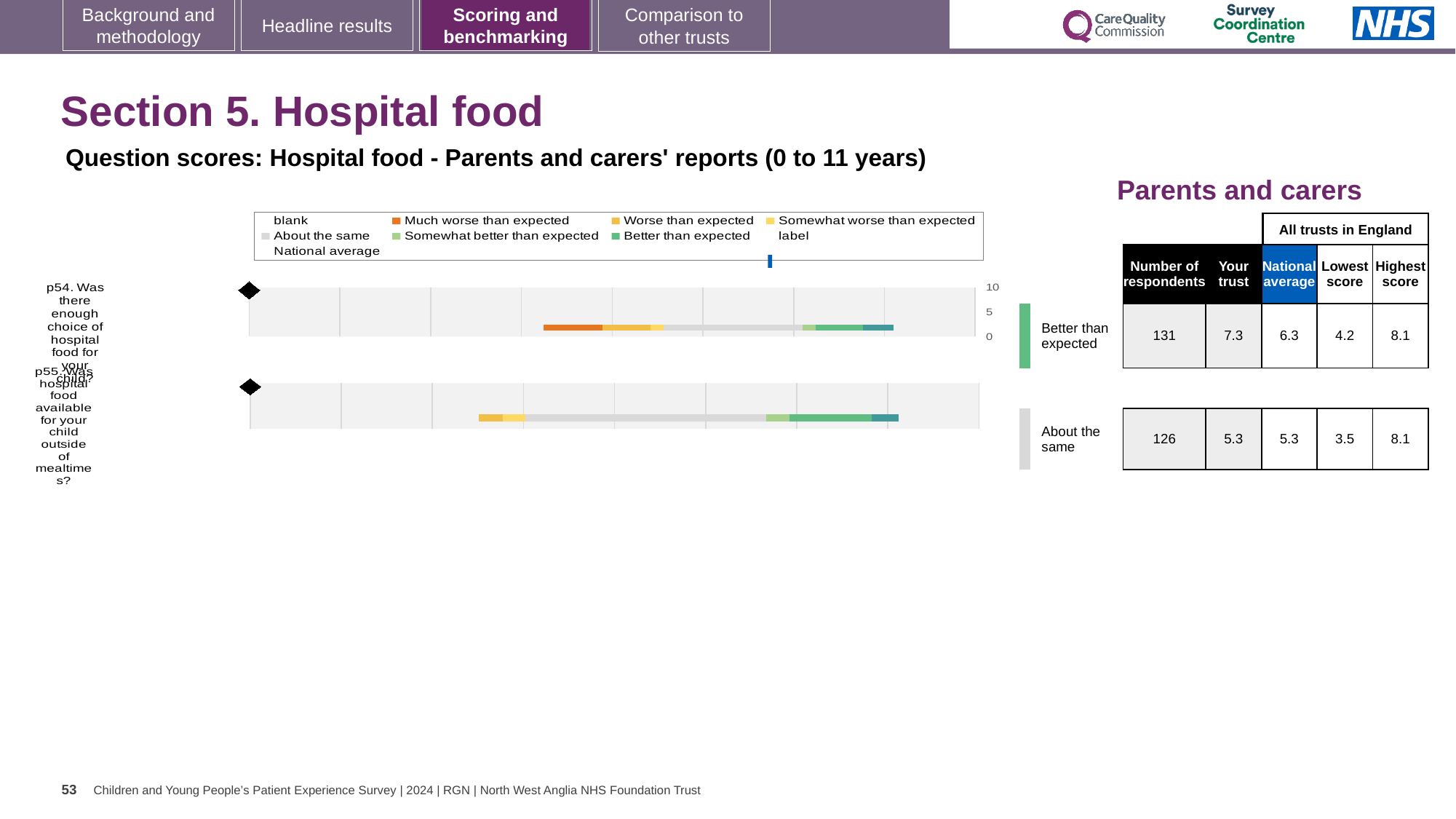
Which question is rated 'Better than expected' for the trust? p54 What is the 'Your trust' score for p54 (enough choice of hospital food for your child)? 7.3 By how much does the trust's score for p54 exceed the national average? 1.0 What is the national average score for p54 (enough choice of hospital food)? 6.3 What is the highest score across all trusts in England for p55? 8.1 What is the lowest score across all trusts in England for p54? 4.2 How many respondents answered p55 (hospital food available outside of mealtimes)? 126 How many questions are plotted in the hospital food chart? 2 What is the 'Your trust' score for p55 (hospital food available outside of mealtimes)? 5.3 What is the maximum value shown on the score axis of the chart? 10 What kind of chart is used to show the question scores for hospital food? bar chart Which is larger for p54: the trust's score or the national average? Your trust